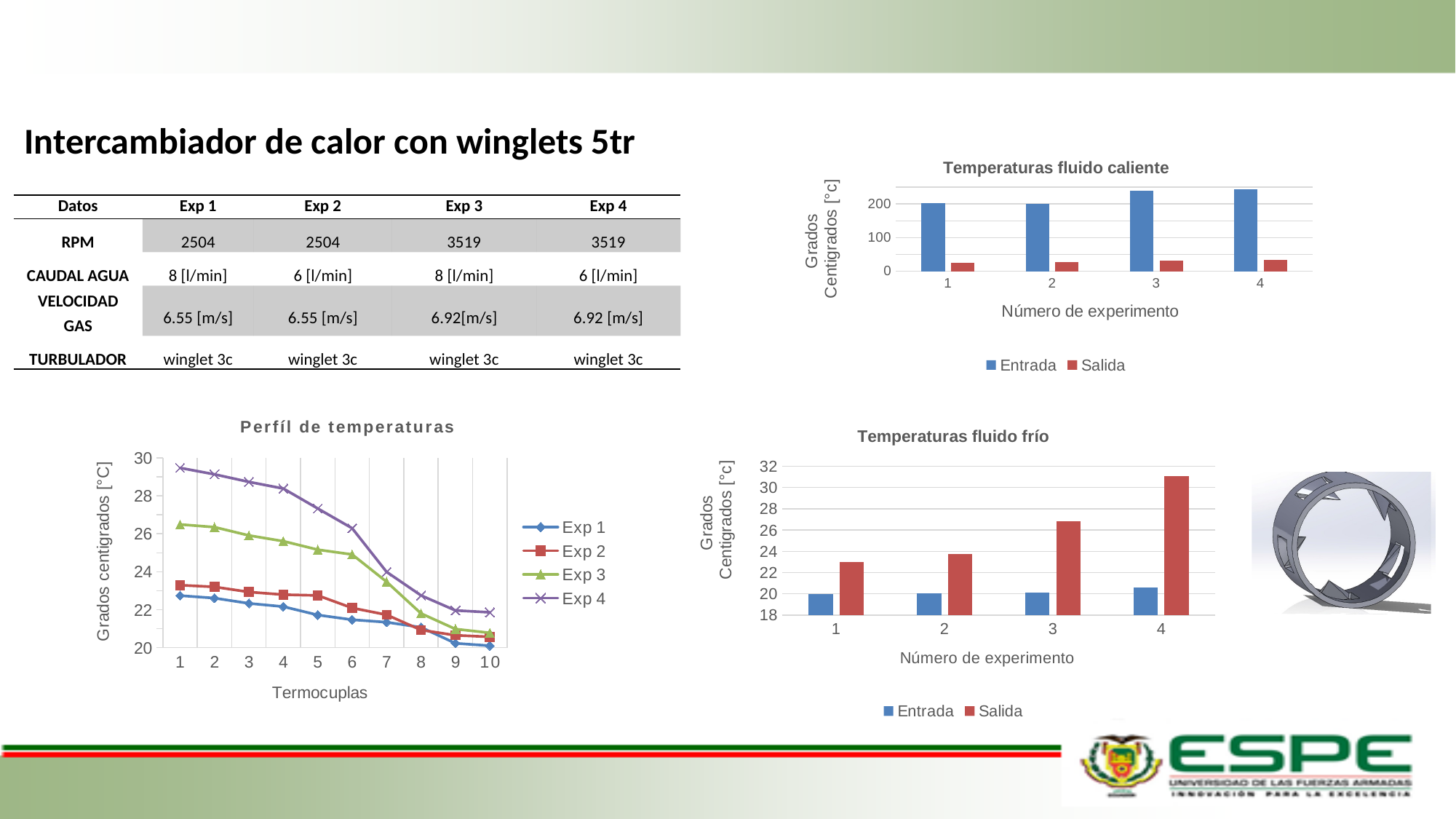
What kind of chart is "Perfíl de temperaturas"? line chart In "Temperaturas fluido frío", is the Salida value for experiment 4 greater or less than 30? greater What kind of chart is "Temperaturas fluido caliente"? bar chart In "Temperaturas fluido caliente", is the Entrada value for experiment 3 greater or less than 200? greater How many series does the legend of "Perfíl de temperaturas" list? 4 In "Perfíl de temperaturas", is the Exp 4 value at thermocouple 1 greater or less than 28? greater In "Temperaturas fluido caliente", which is larger for experiment 1, Entrada or Salida? Entrada In "Perfíl de temperaturas", which series has the highest value at thermocouple 1? Exp 4 How many series does the legend of "Temperaturas fluido caliente" list? 2 In "Perfíl de temperaturas", do the values rise or fall as the thermocouple number increases? fall In "Temperaturas fluido frío", which experiment has the highest Salida value? 4